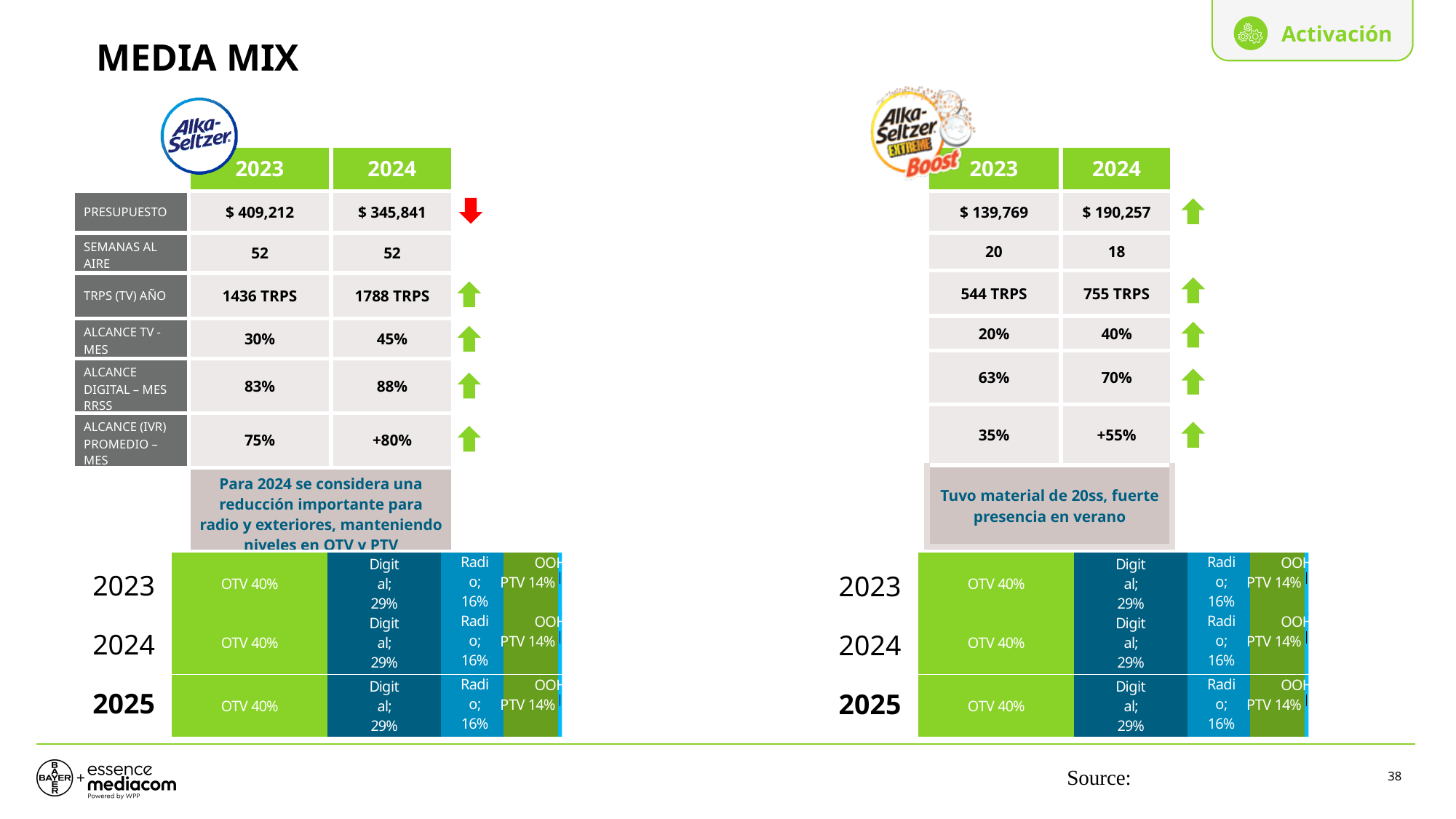
How many years (bars) are shown in the bottom-right chart? 3 In the bottom-right chart, what is the Digital share for 2023? 29% What kind of chart is shown at the bottom left of the slide? Stacked bar chart In the bottom-left chart, what is the difference between the OTV share and the Digital share for 2025? 11 percentage points In the bottom-right chart, what is the OTV share for 2025? 40% In the bottom-left chart, what is the Radio share for 2025? 16% In the bottom-left chart, which labelled medium has the largest share in 2024? OTV In the bottom-left chart, what is the OTV share for 2023? 40% In the bottom-right chart, which is larger for 2023, the Radio share or the PTV share? Radio In the bottom-left chart, what is the PTV share for 2023? 14% In the bottom-right chart, what is the PTV share for 2024? 14% In the bottom-left chart, what is the Digital share for 2024? 29%